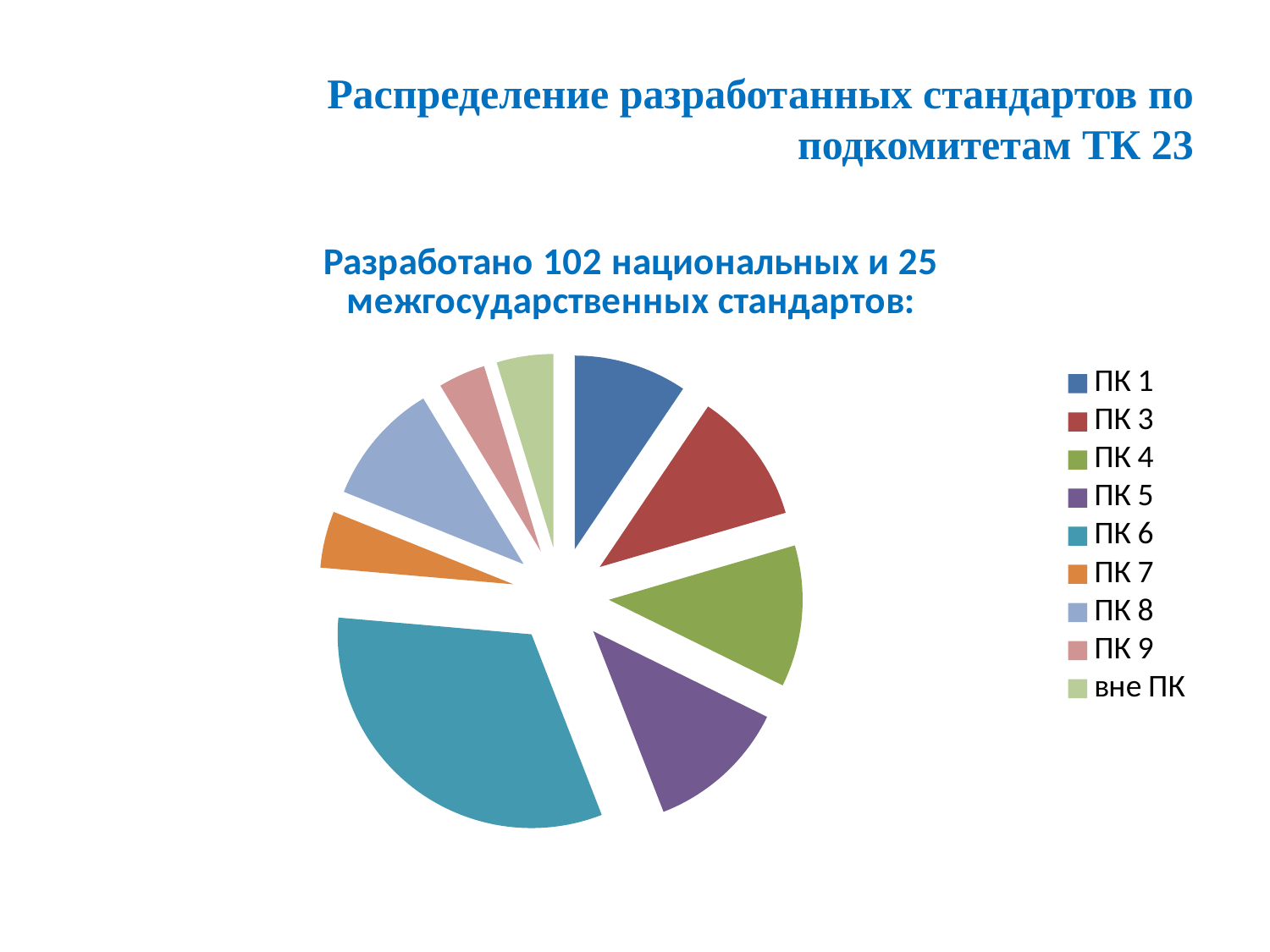
How many entries does the legend of the pie chart list? 9 Which slice is larger, ПК 6 or ПК 1? ПК 6 Which category has the largest slice in the pie chart? ПК 6 Which slice is larger, ПК 5 or вне ПК? ПК 5 What is the title of the pie chart? Разработано 102 национальных и 25 межгосударственных стандартов: Which slice is larger, ПК 8 or ПК 9? ПК 8 How many slices (categories) does the pie chart have? 9 What kind of chart is shown on the slide? pie chart